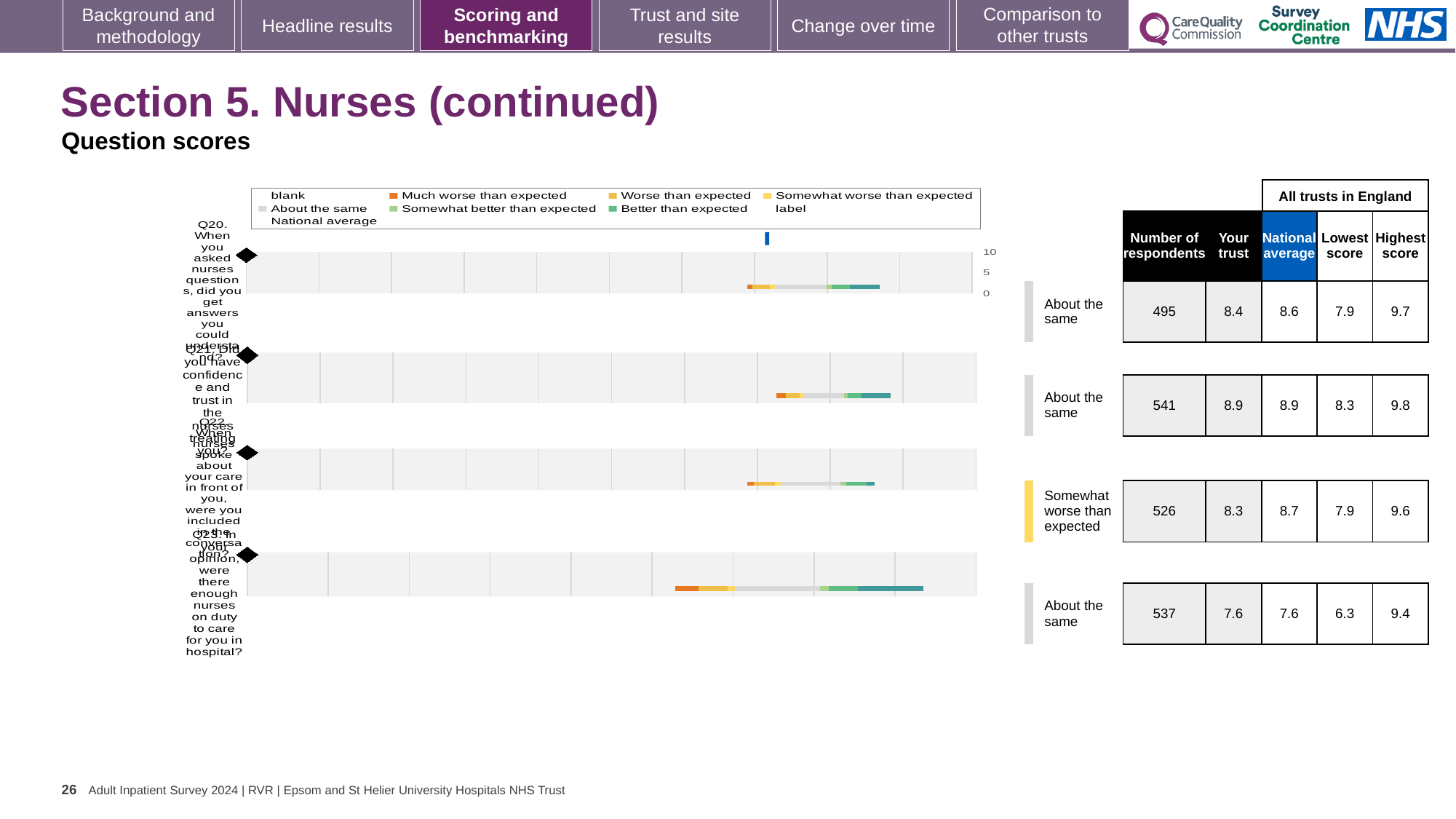
Which question has the highest 'Your trust' score? Q21 For Q22, what is the difference between the highest score and the lowest score across all trusts in England? 1.7 Which question's chart is rated 'Somewhat worse than expected'? Q22 How many question charts (Q20 to Q23) are shown on the slide? 4 How many respondents are shown for the Q21 chart? 541 What is the national average shown for the Q22 chart? 8.7 What is the 'Your trust' score shown for the Q20 chart? 8.4 What kind of chart is used to show the question scores for Q20 to Q23? bar chart What colour does the legend use for 'Much worse than expected'? orange On the Q23 chart, is the 'Your trust' score greater or less than 5? greater For Q20, which is larger: the 'Your trust' score or the national average? National average Which question has the lowest 'Your trust' score? Q23